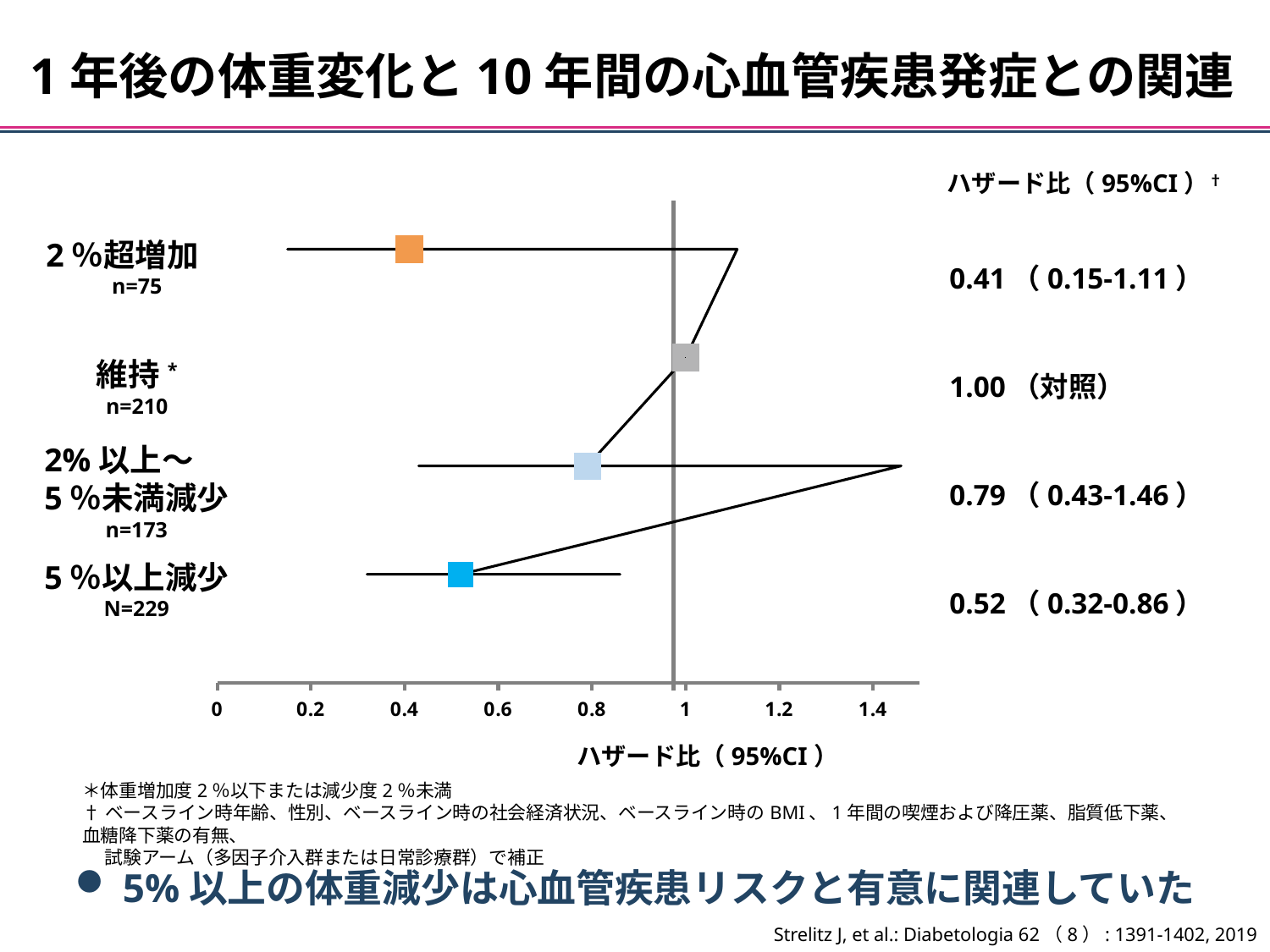
Which group has the highest hazard ratio? 維持 (対照) What is the 95% CI for the 5%以上減少 group? 0.32-0.86 What is the label of the horizontal axis? ハザード比（95%CI） What is the hazard ratio for the 2%超増加 group? 0.41 What is the hazard ratio for the 5%以上減少 group? 0.52 Is the hazard ratio for the 2%以上～5%未満減少 group greater or less than 1? less How many participants (n) are in the 維持 group? n=210 Which group has the lowest hazard ratio? 2%超増加 What is the 95% CI for the 2%以上～5%未満減少 group? 0.43-1.46 Which has a larger hazard ratio, the 2%以上～5%未満減少 group or the 5%以上減少 group? 2%以上～5%未満減少 What is the difference between the hazard ratio of the 維持 group and the 5%以上減少 group? 0.48 How many weight-change groups are plotted in the chart? 4